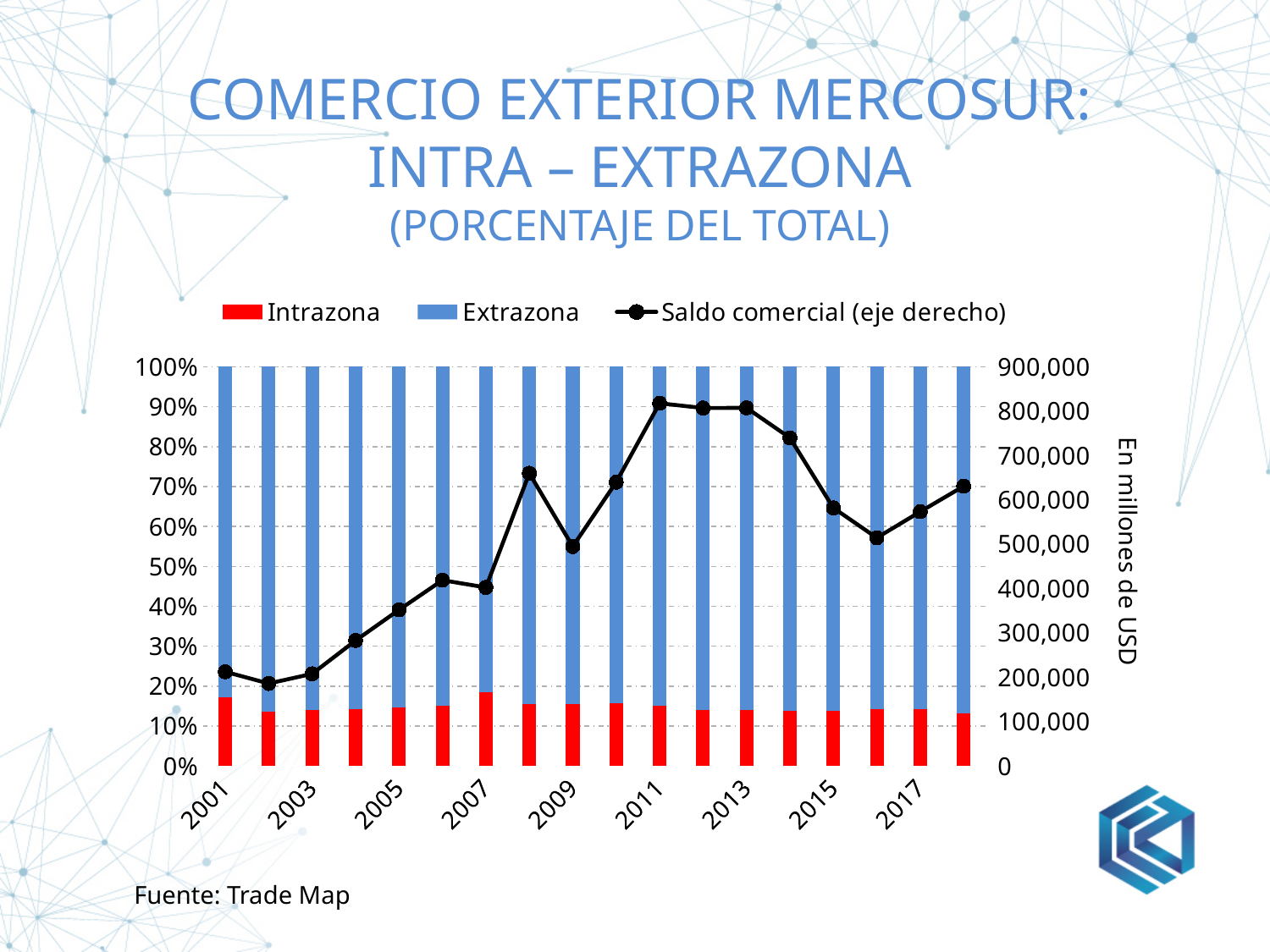
Is the Saldo comercial value for 2011 greater or less than 700,000? greater Is the Saldo comercial value for 2008 greater or less than 600,000? greater What is the label of the right-hand vertical axis? En millones de USD In 2011, which is larger, the Intrazona share or the Extrazona share? Extrazona How many series does the legend list? 3 Is the Saldo comercial value for 2005 greater or less than 300,000? greater In which year is the Saldo comercial line at its lowest? 2002 Does the Saldo comercial line rise or fall between 2002 and 2011? rise What kind of chart is this? Combined stacked bar and line chart Does the Saldo comercial line rise or fall between 2013 and 2016? fall How many years (bars) are plotted on the x axis? 18